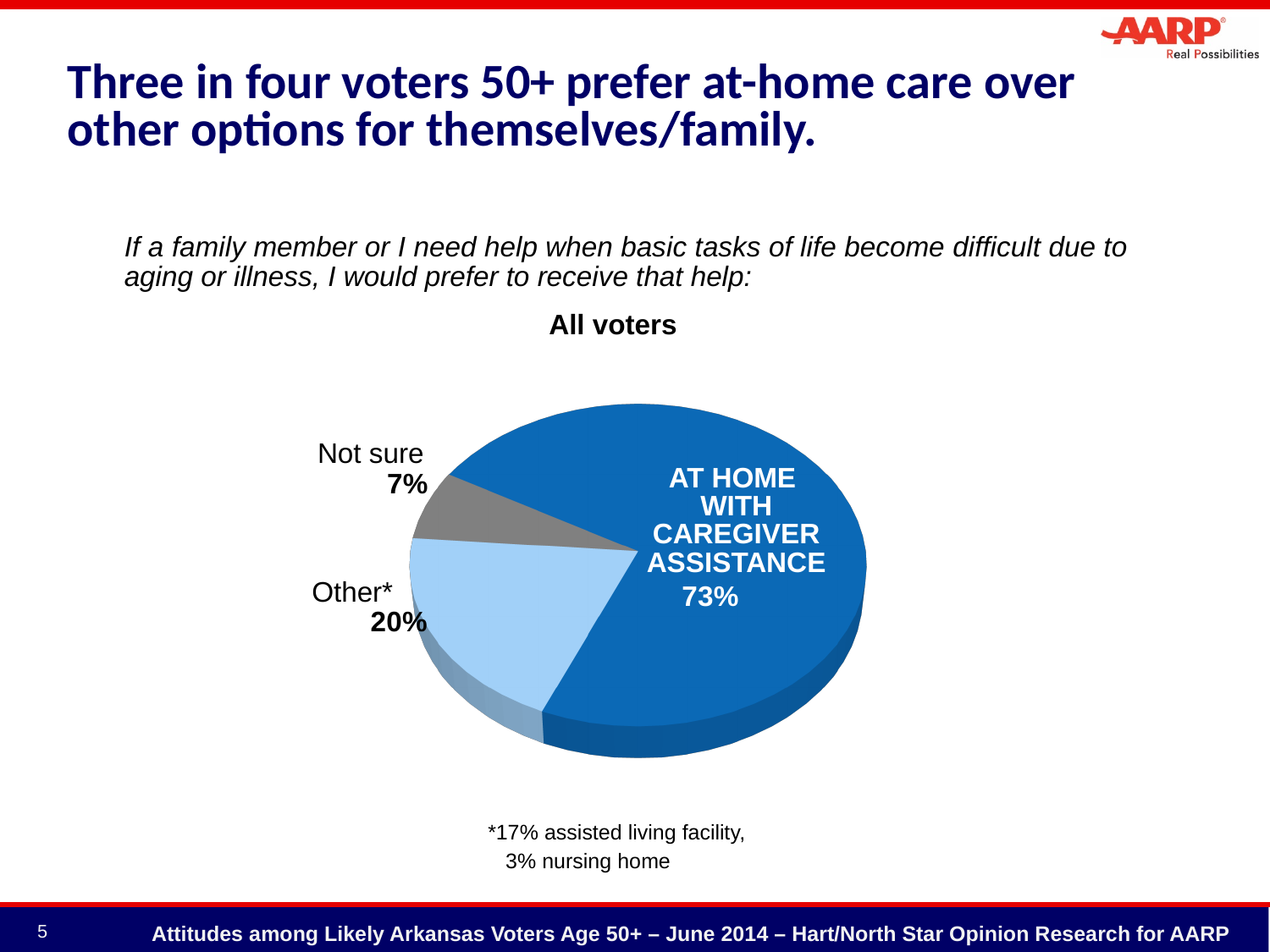
What is the title shown above the pie chart? All voters What percentage of voters chose Other*? 20% What is the difference in percentage points between Other* and Not sure? 13 According to the footnote, what percentage chose an assisted living facility? 17% What percentage of voters are Not sure? 7% What share of all voters prefer at home with caregiver assistance? 73% Which is larger, the Other* slice or the Not sure slice? Other* How many slices does the pie chart have? 3 Which slice of the pie is the smallest? Not sure What is the difference in percentage points between the at home with caregiver assistance slice and the Other* slice? 53 What kind of chart is shown on the slide? Pie chart Which slice of the pie is the largest? At home with caregiver assistance